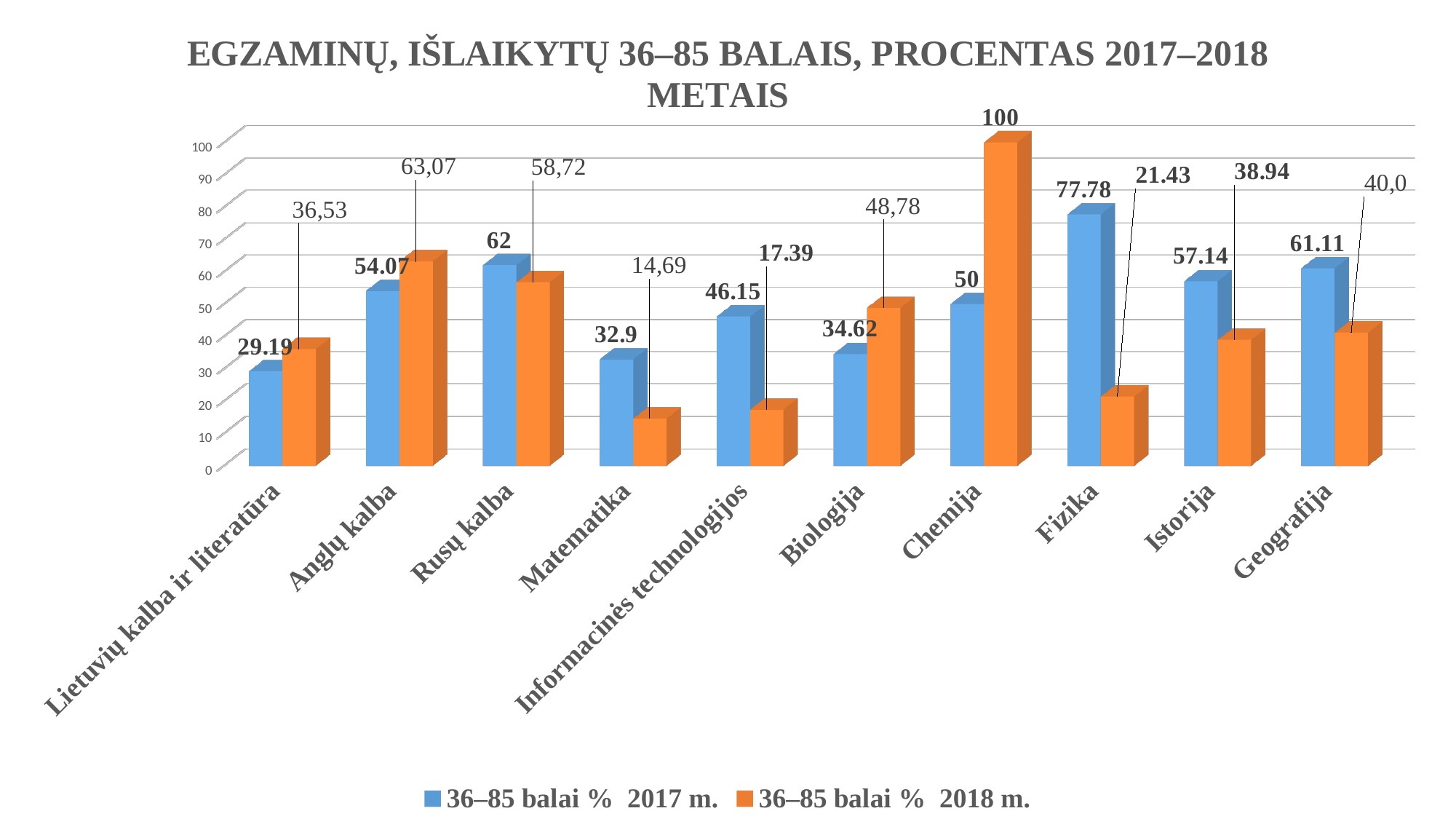
What kind of chart is shown on the slide? Bar chart How many series does the legend list? 2 What is the value for Chemija in the 36–85 balai % 2018 m. series? 100 For Rusų kalba, which series has the larger value, 2017 m. or 2018 m.? 36–85 balai % 2017 m. Which category has the lowest value in the 36–85 balai % 2018 m. series? Matematika What is the difference between the 2017 and 2018 values for Fizika? 56.35 Which category has the highest value in the 36–85 balai % 2017 m. series? Fizika What is the value for Matematika in the 36–85 balai % 2018 m. series? 14,69 What is the value for Fizika in the 36–85 balai % 2017 m. series? 77.78 How many categories are shown on the x axis? 10 What is the value for Istorija in the 36–85 balai % 2018 m. series? 38.94 What is the difference between the 2018 and 2017 values for Chemija? 50